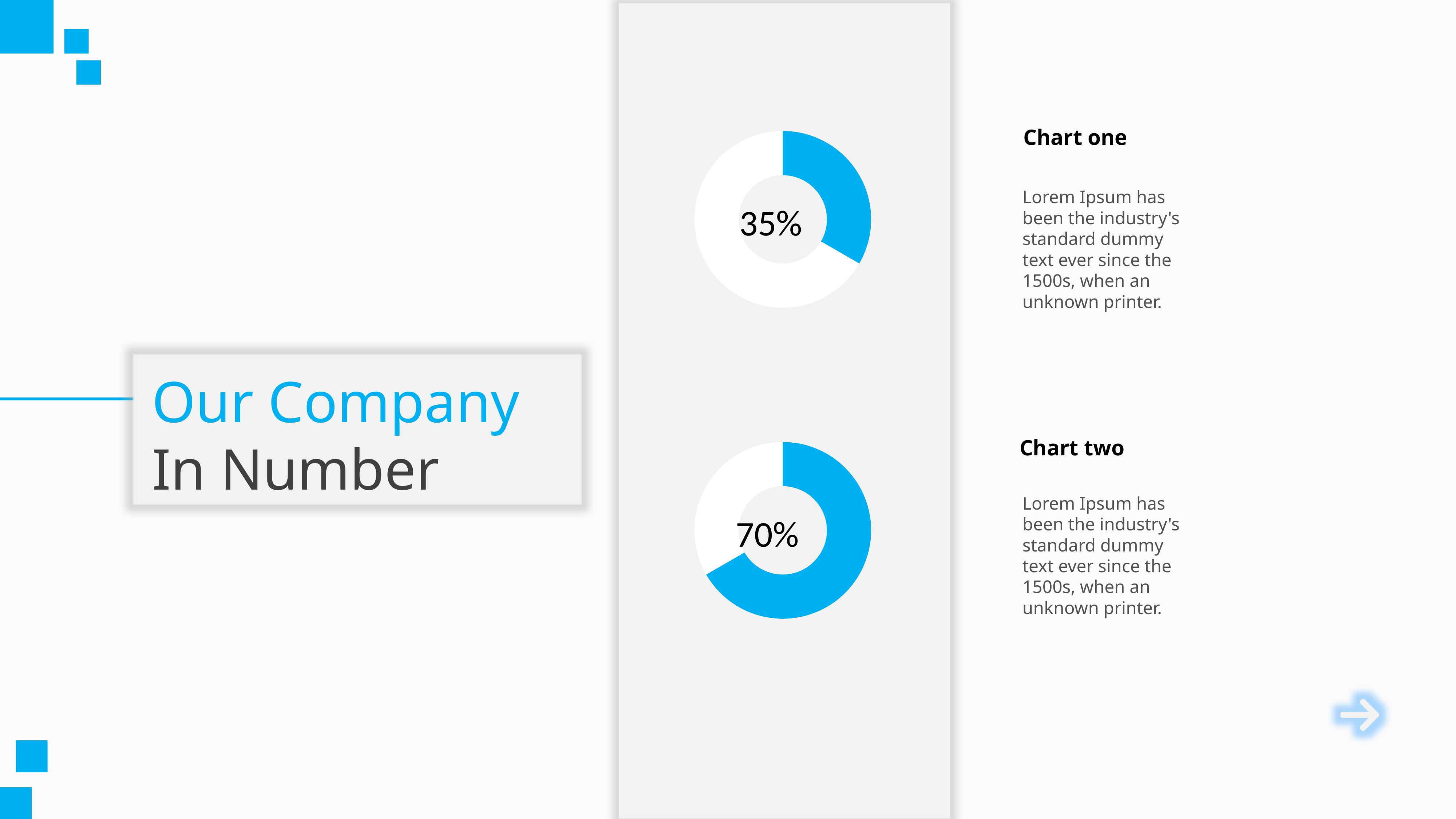
Which chart shows the higher percentage, Chart one or Chart two? Chart two What percentage is shown in the centre of the bottom doughnut chart (Chart two)? 70% What share of the bottom doughnut chart is left unfilled (white)? 30% In the top doughnut chart, is the blue filled portion greater or less than 50%? less What is the title of the slide containing the two doughnut charts? Our Company In Number What kind of chart is used for Chart one? Doughnut chart What share of the top doughnut chart is left unfilled (white)? 65% What colour is the filled portion of the doughnut charts? Blue How many doughnut charts are shown on the slide? 2 In the bottom doughnut chart, is the blue filled portion greater or less than 50%? greater What is the difference between the percentage in Chart two and the percentage in Chart one? 35% What percentage is shown in the centre of the top doughnut chart (Chart one)? 35%